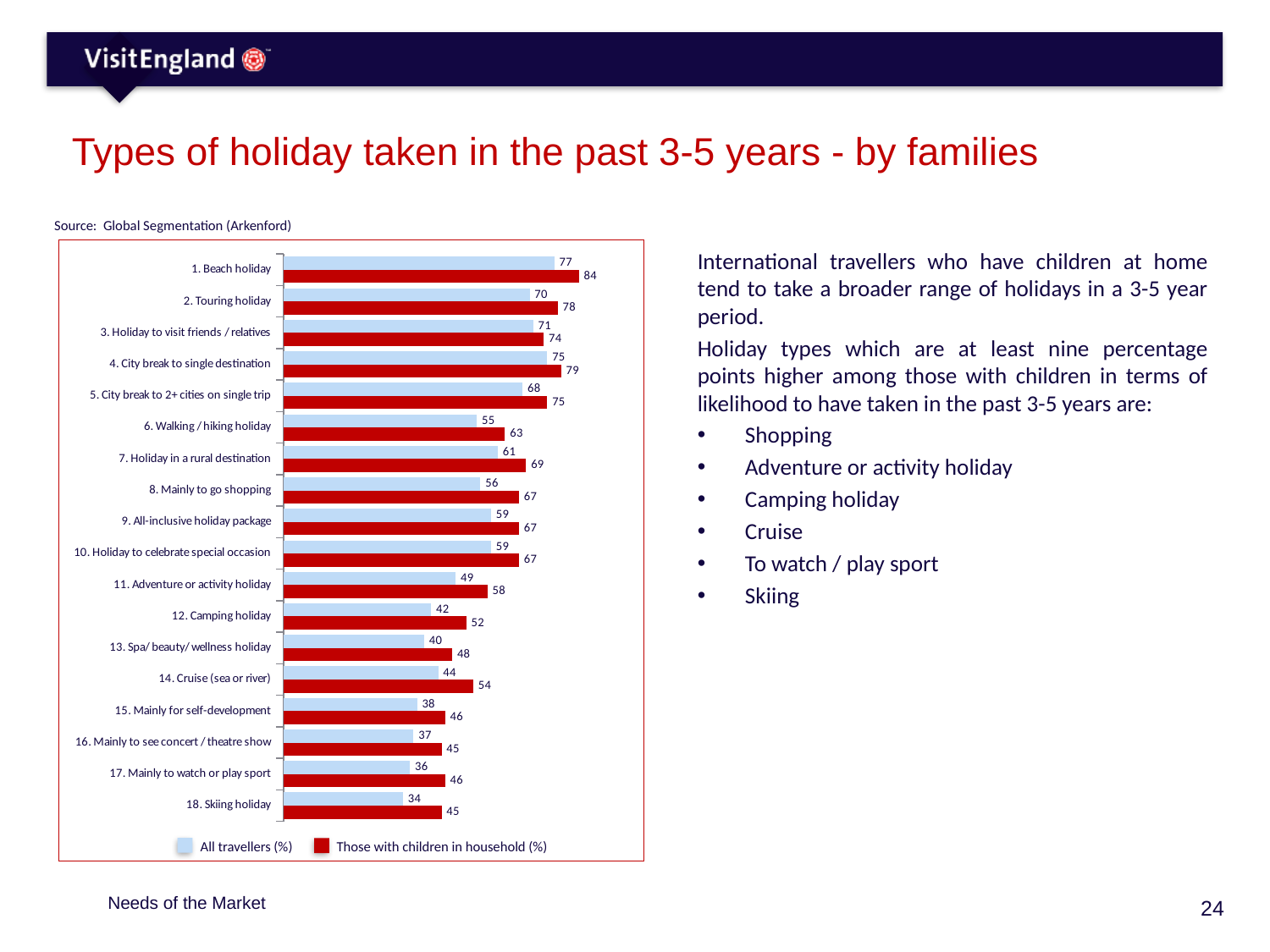
What colour represents 'Those with children in household (%)' in the chart? Red What is the difference between 'Those with children in household (%)' and 'All travellers (%)' for Skiing holiday? 11 How many holiday types are shown in the chart? 18 What is the value for 'Those with children in household (%)' for Beach holiday? 84 What is the value for 'All travellers (%)' for Camping holiday? 42 Which holiday type has the lowest value for 'Those with children in household (%)'? Mainly to see concert / theatre show and Skiing holiday (both 45) Which is larger for Cruise (sea or river): the value for 'All travellers (%)' or for 'Those with children in household (%)'? Those with children in household (%) What is the difference between 'Those with children in household (%)' and 'All travellers (%)' for Mainly to go shopping? 11 Which holiday type has the highest value for 'All travellers (%)'? Beach holiday What is the value for 'All travellers (%)' for Walking / hiking holiday? 55 What kind of chart is shown on the slide? Bar chart How many series does the legend list? 2